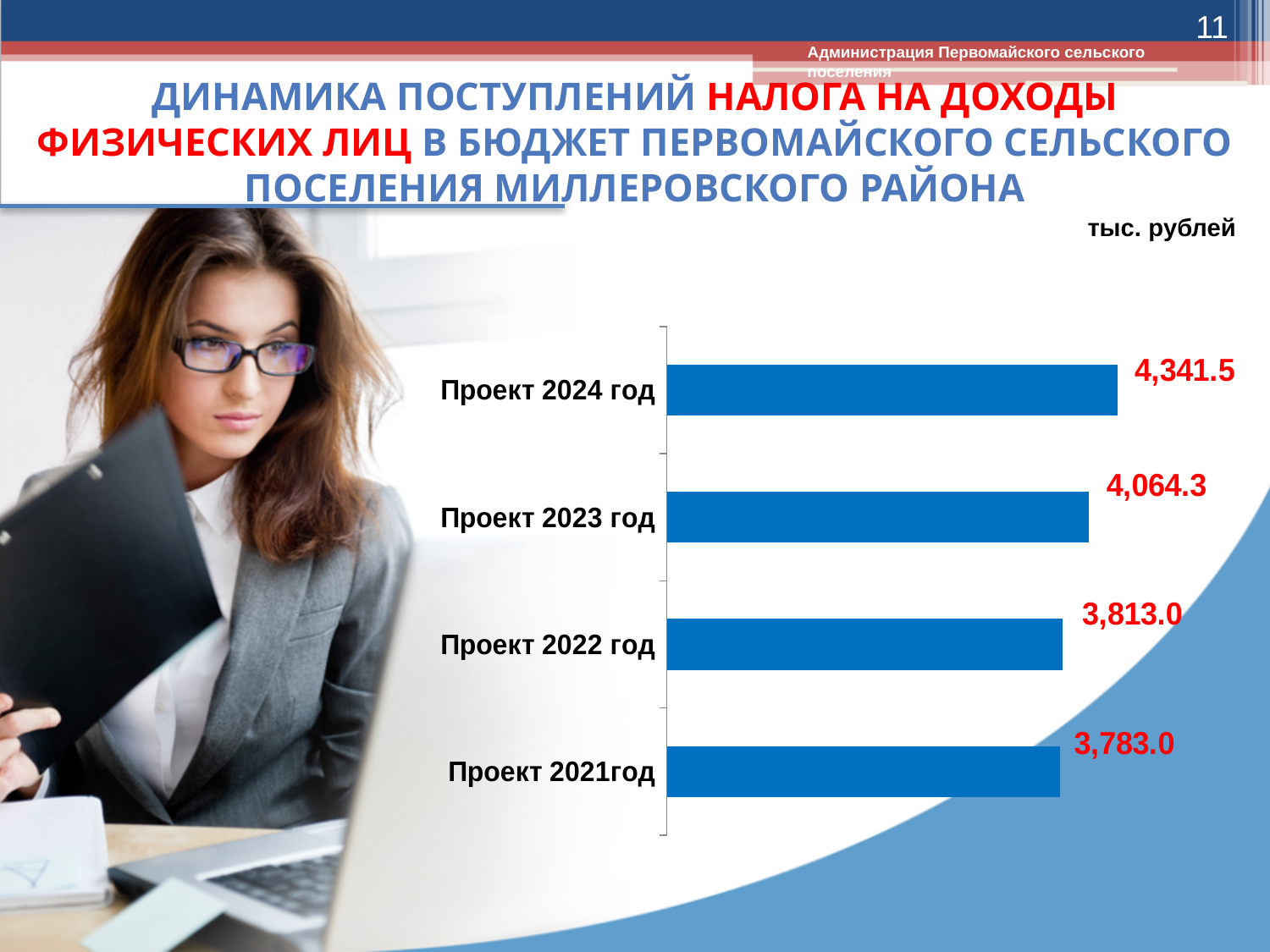
How many categories are shown in the chart? 4 What is the value for Проект 2024 год? 4,341.5 What kind of chart is shown on the slide? Bar chart Which is larger, the value for Проект 2023 год or Проект 2022 год? Проект 2023 год Which category has the lowest value? Проект 2021год What is the value for Проект 2021год? 3,783.0 Which category has the highest value? Проект 2024 год What is the value for Проект 2023 год? 4,064.3 What is the value for Проект 2022 год? 3,813.0 What is the difference between the values for Проект 2024 год and Проект 2021год? 558.5 What is the difference between the values for Проект 2024 год and Проект 2023 год? 277.2 In what units are the chart values given? тыс. рублей